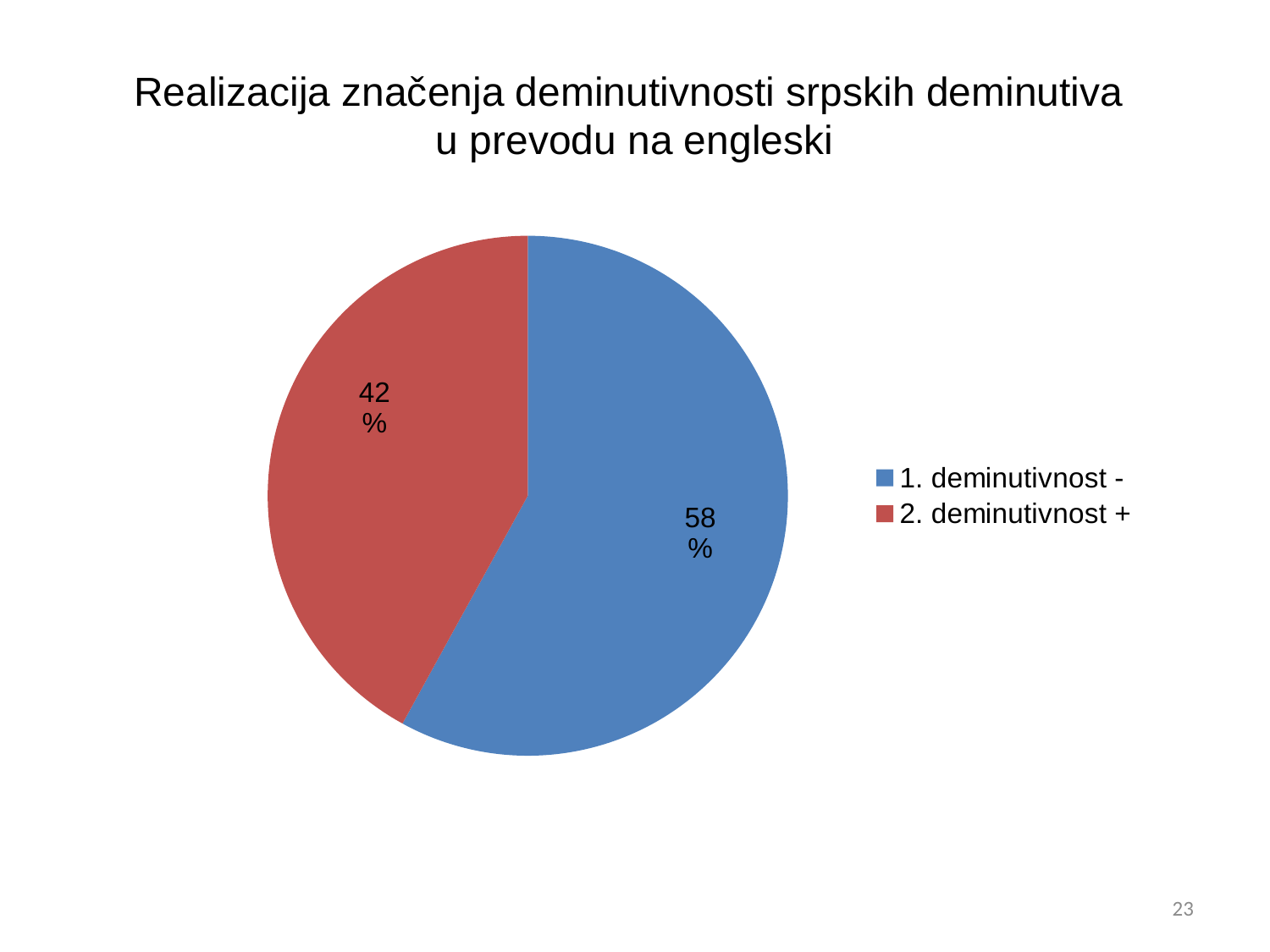
Which category has the largest slice of the pie? 1. deminutivnost - How many entries does the legend list? 2 What colour is the slice for "2. deminutivnost +"? red What share of the pie does "1. deminutivnost -" have? 58% Which slice is larger, "1. deminutivnost -" or "2. deminutivnost +"? 1. deminutivnost - What kind of chart is shown on the slide? pie chart What is the title of the slide containing the pie chart? Realizacija značenja deminutivnosti srpskih deminutiva u prevodu na engleski What is the difference in percentage points between the "1. deminutivnost -" slice and the "2. deminutivnost +" slice? 16 How many slices does the pie chart have? 2 Which category has the smallest slice of the pie? 2. deminutivnost + What share of the pie does "2. deminutivnost +" have? 42%